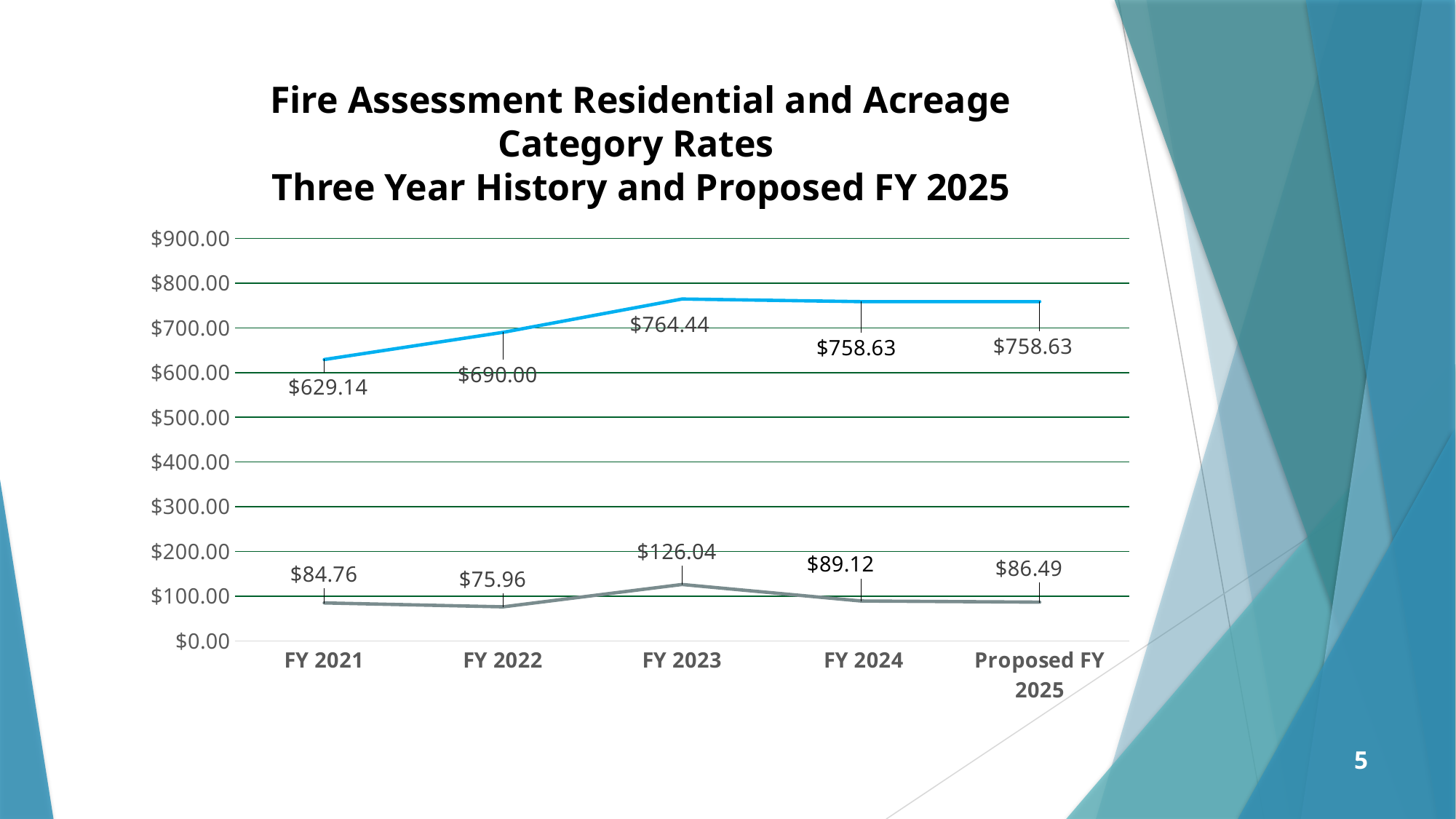
What type of chart is shown on the slide? line chart In which fiscal year does the blue line reach its highest value? FY 2023 Does the blue line rise or fall from FY 2021 to FY 2023? rise In which fiscal year does the gray line have its lowest value? FY 2022 What is the value of the blue line for Proposed FY 2025? $758.63 What is the title of the chart? Fire Assessment Residential and Acreage Category Rates Three Year History and Proposed FY 2025 How many fiscal year categories are shown on the x axis? 5 What is the value of the gray line for FY 2022? $75.96 What is the difference between the blue line's FY 2022 value and its FY 2021 value? $60.86 For the gray line, which is larger: the FY 2024 value or the Proposed FY 2025 value? FY 2024 What is the value of the blue line for FY 2023? $764.44 What is the difference between the gray line's FY 2023 value and its FY 2024 value? $36.92